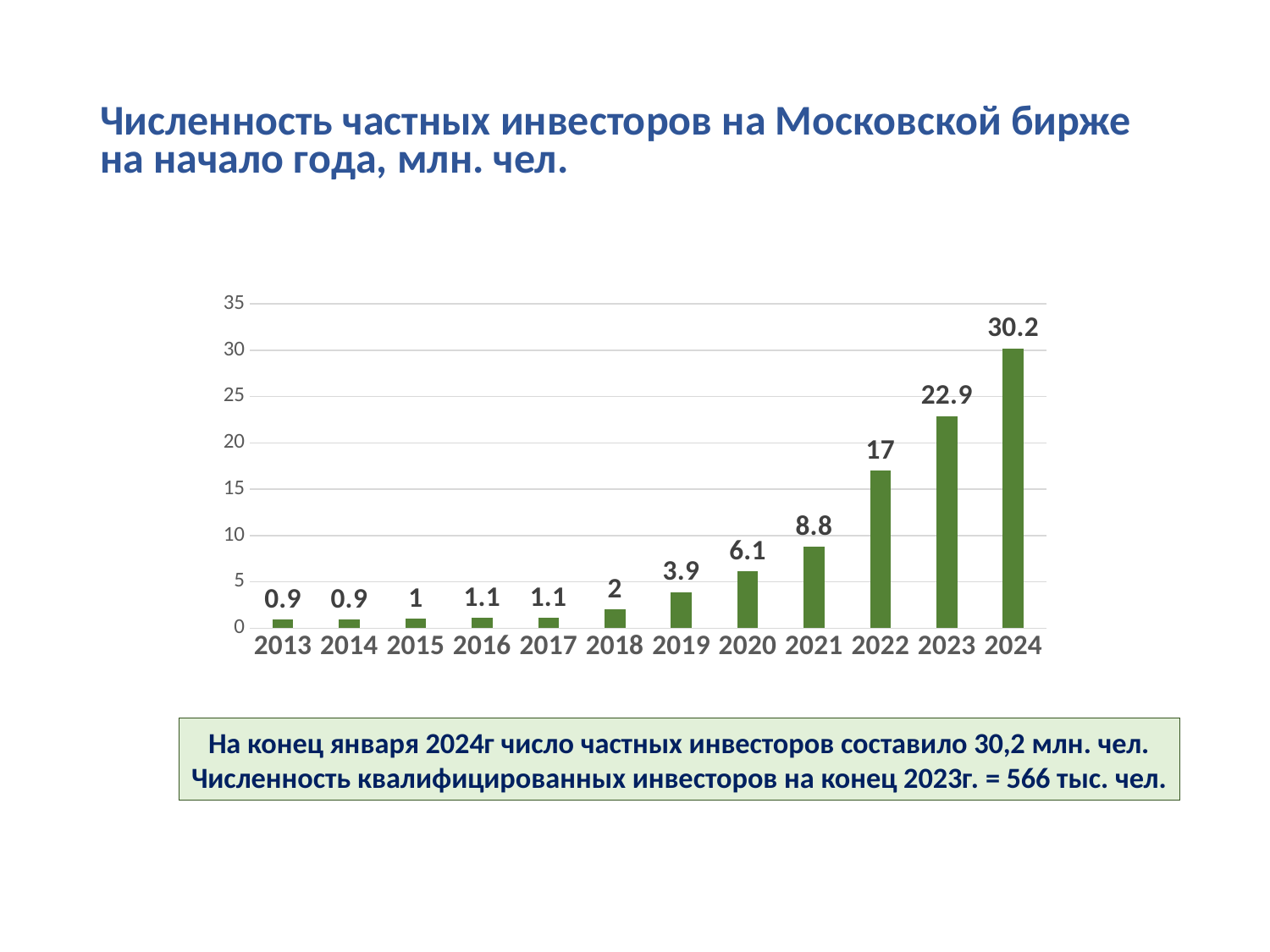
What kind of chart is this? bar chart Do the values rise or fall from 2013 to 2024? rise What is the title of the slide? Численность частных инвесторов на Московской бирже на начало года, млн. чел. Which is larger, the value for 2018 or the value for 2019? 2019 What is the value for 2024? 30.2 What is the value for 2022? 17 What is the difference between the values for 2021 and 2020? 2.7 Is the value for 2023 greater or less than 20? greater What is the difference between the values for 2024 and 2023? 7.3 What is the value for 2019? 3.9 Which year has the highest value? 2024 How many years are shown on the x axis? 12